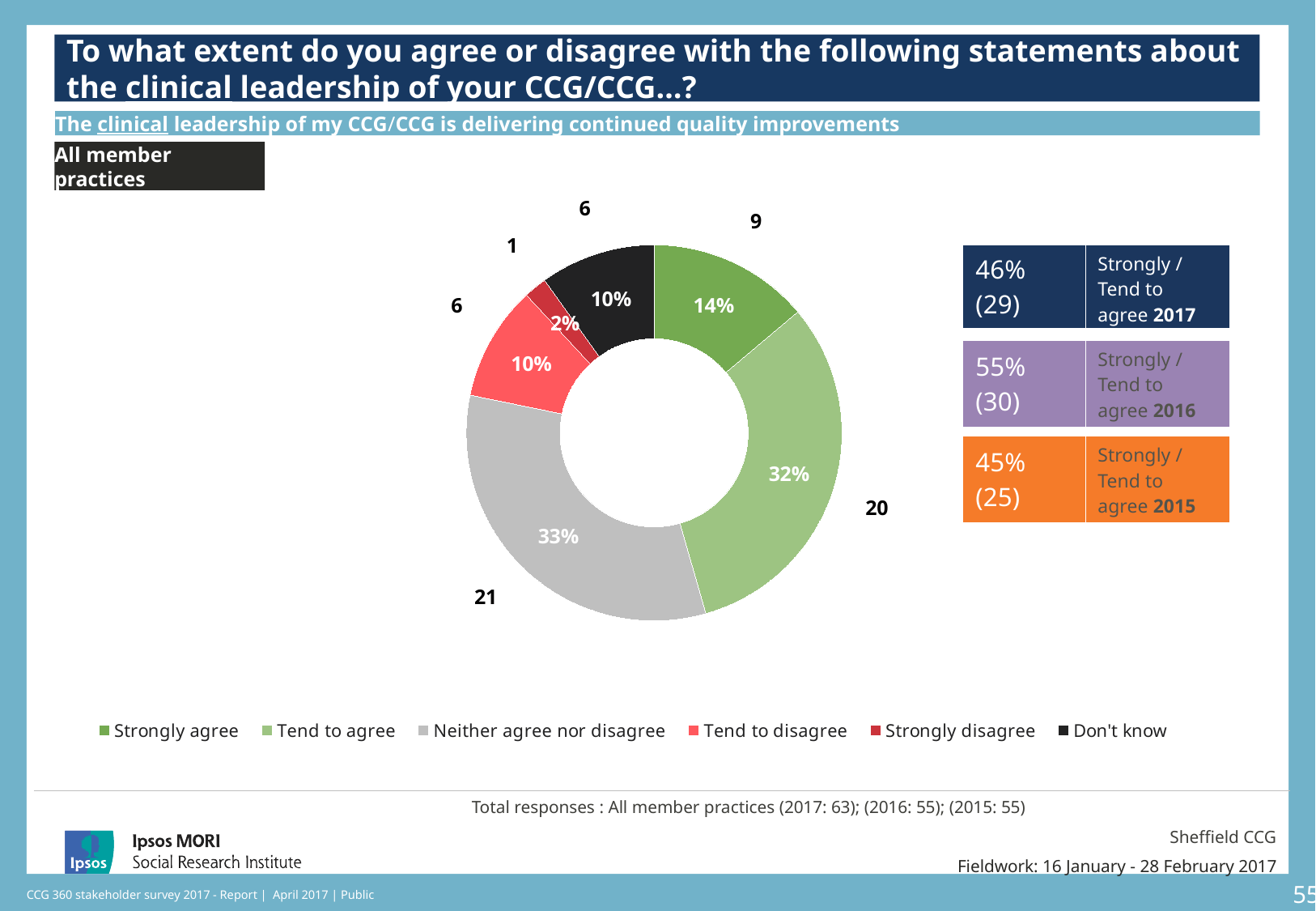
What percentage of respondents said they 'Tend to agree' that the clinical leadership of their CCG is delivering continued quality improvements? 32% What percentage of respondents answered 'Don't know'? 10% How many entries does the legend list? 6 What is the difference in percentage points between 'Tend to agree' and 'Strongly agree'? 18 percentage points What colour represents 'Neither agree nor disagree' in the chart? Grey How many response categories are shown in the pie chart? 6 What was the combined 'Strongly / Tend to agree' percentage in 2017? 46% How many respondents (count) answered 'Neither agree nor disagree'? 21 Which is larger: the share for 'Strongly agree' or the share for 'Tend to disagree'? Strongly agree What percentage of respondents 'Strongly agree'? 14% Which response category has the smallest share of the pie? Strongly disagree What type of chart is used on this slide? Pie (donut) chart